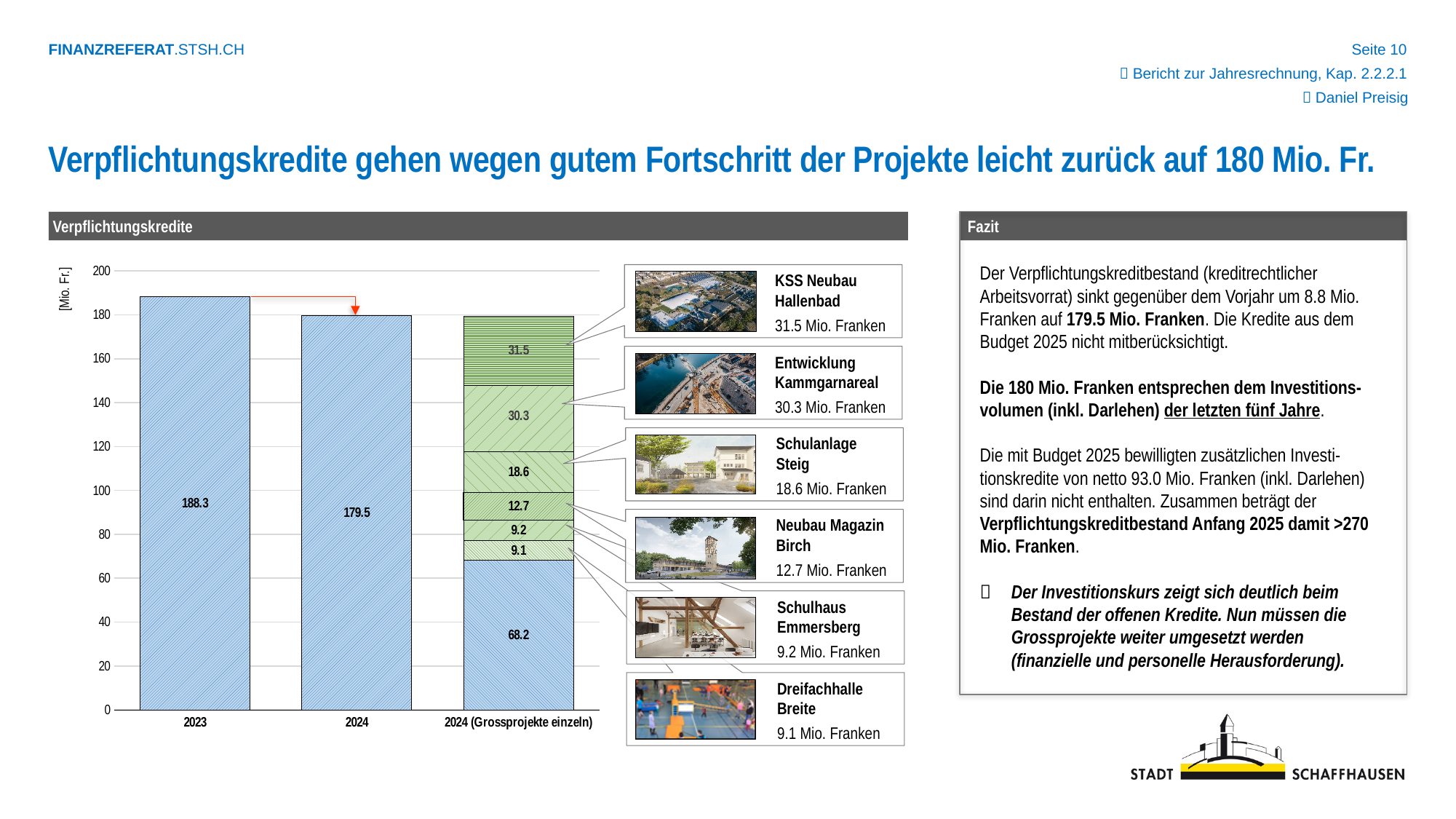
Which year has the higher Verpflichtungskredite value, 2023 or 2024? 2023 Is the value for 2023 greater or less than 180? greater How many categories are shown on the x axis of the chart? 3 What unit is shown on the y axis of the chart? [Mio. Fr.] In the stacked bar for 2024 (Grossprojekte einzeln), what is the value of the segment for Entwicklung Kammgarnareal? 30.3 What is the value of the Verpflichtungskredite bar for 2024? 179.5 Which category on the x axis has the highest bar? 2023 By how much did the Verpflichtungskredite value fall from 2023 to 2024? 8.8 In the stacked bar for 2024 (Grossprojekte einzeln), what is the value of the segment for KSS Neubau Hallenbad? 31.5 What is the value of the Verpflichtungskredite bar for 2023? 188.3 What kind of chart is shown under the heading Verpflichtungskredite? bar chart Do the Verpflichtungskredite values rise or fall from 2023 to 2024? fall